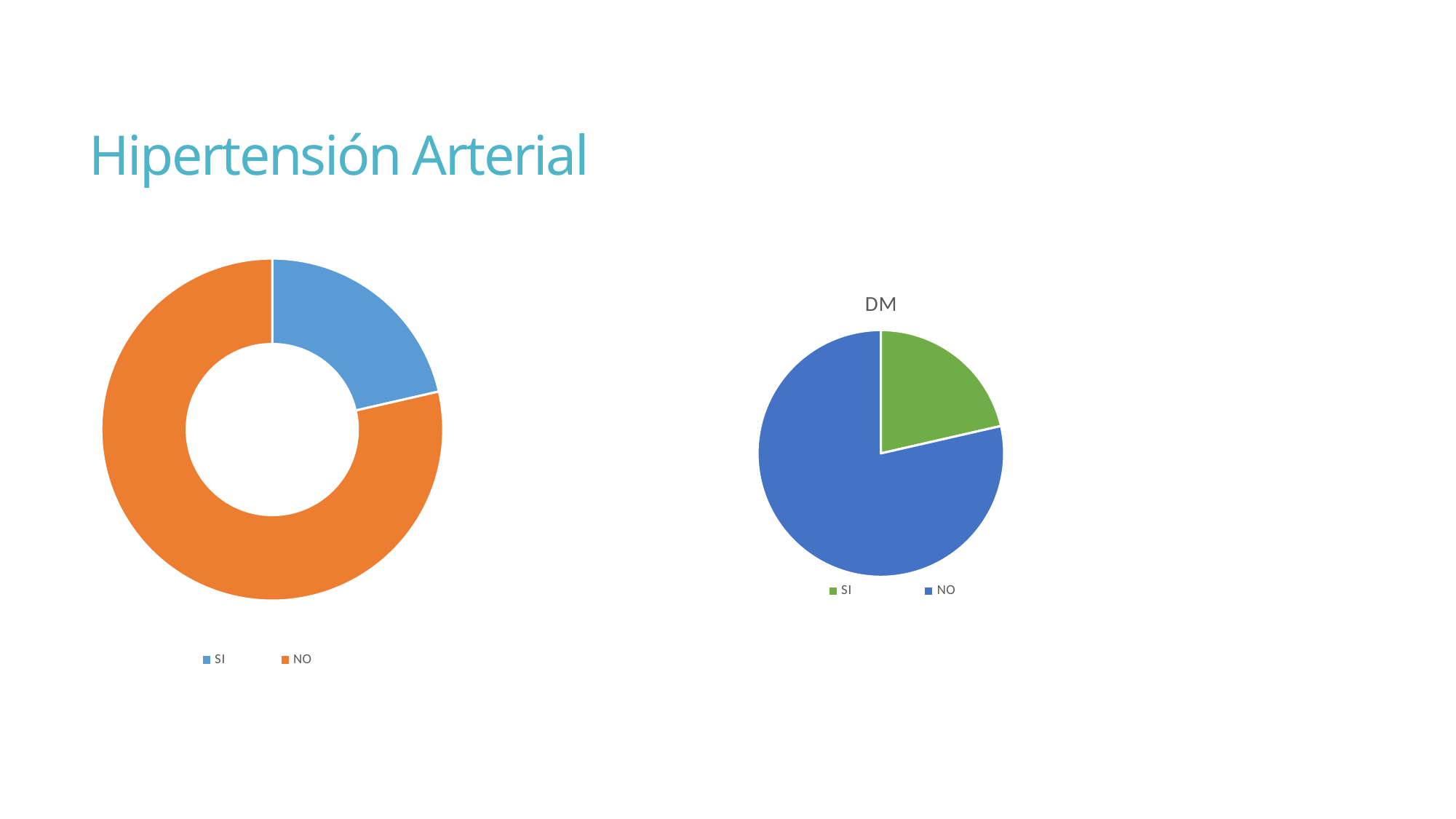
In the chart on the left of the slide, which category has the smallest slice? SI What kind of chart is the chart titled DM? pie chart In the chart on the left of the slide, is the slice for NO larger or smaller than the slice for SI? larger In the chart titled DM, which category has the smallest slice? SI In the chart titled DM, what colour is the SI slice? green In the chart titled DM, is the slice for SI larger or smaller than the slice for NO? smaller In the chart titled DM, which category has the largest slice? NO How many categories does the chart titled DM show? 2 How many categories does the chart on the left of the slide show? 2 What is the title of the chart on the right of the slide? DM What kind of chart is the chart on the left of the slide? doughnut chart In the chart on the left of the slide, which category has the largest slice? NO